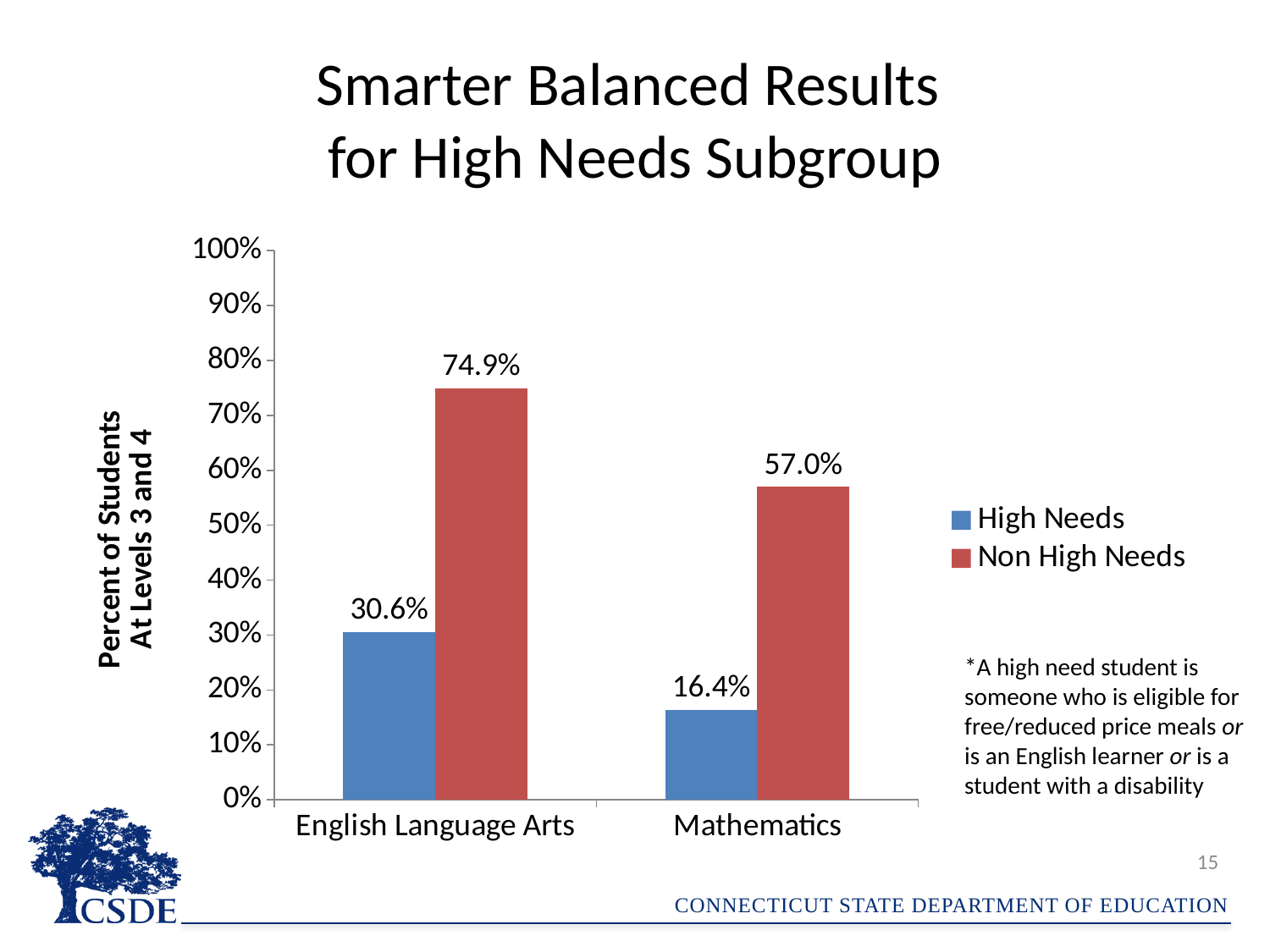
How many series does the legend list? 2 Which bar on the chart has the lowest value? High Needs, Mathematics What is the value for High Needs students in Mathematics? 16.4% Which is larger: the High Needs value in English Language Arts or the High Needs value in Mathematics? English Language Arts What is the difference between Non High Needs and High Needs students in Mathematics? 40.6 percentage points What percent of High Needs students scored at Levels 3 and 4 in English Language Arts? 30.6% What kind of chart is shown on the slide? Bar chart Which bar on the chart has the highest value? Non High Needs, English Language Arts What is the difference between Non High Needs and High Needs students in English Language Arts? 44.3 percentage points What percent of Non High Needs students scored at Levels 3 and 4 in Mathematics? 57.0% What is the label on the vertical axis of the chart? Percent of Students At Levels 3 and 4 What is the value for Non High Needs students in English Language Arts? 74.9%